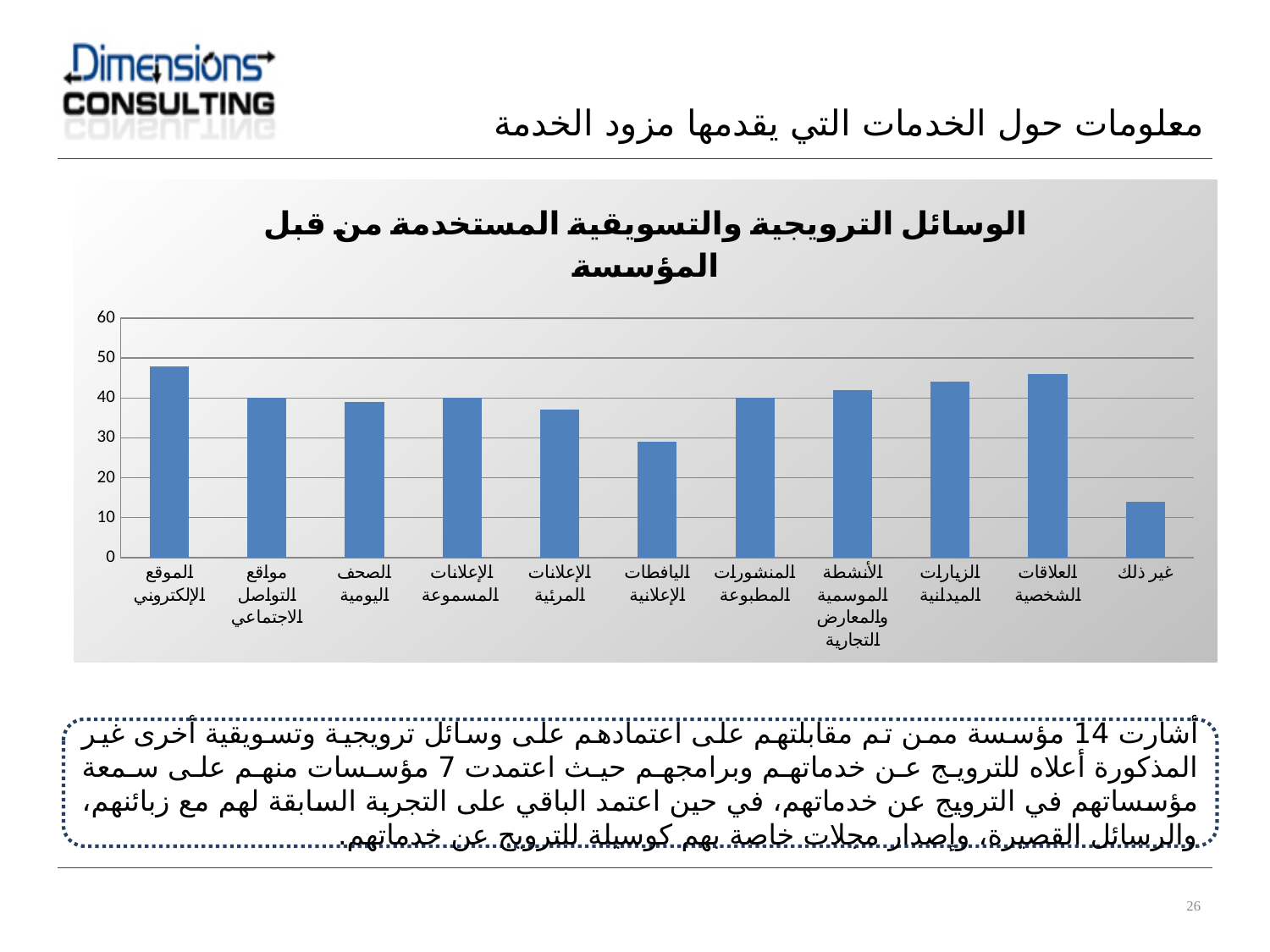
What kind of chart is shown on the slide? bar chart What is the title of the chart? الوسائل الترويجية والتسويقية المستخدمة من قبل المؤسسة How many categories are shown on the x axis of the chart? 11 Which is larger, the value for اليافطات الإعلانية or the value for غير ذلك? اليافطات الإعلانية Is the value for غير ذلك greater or less than 20? less Which category has the highest bar in the chart? الموقع الإلكتروني Is the value for الموقع الإلكتروني greater or less than 40? greater Which category has the lowest bar in the chart? غير ذلك Is the value for اليافطات الإعلانية greater or less than 40? less Which is larger, the value for الزيارات الميدانية or the value for الإعلانات المرئية? الزيارات الميدانية